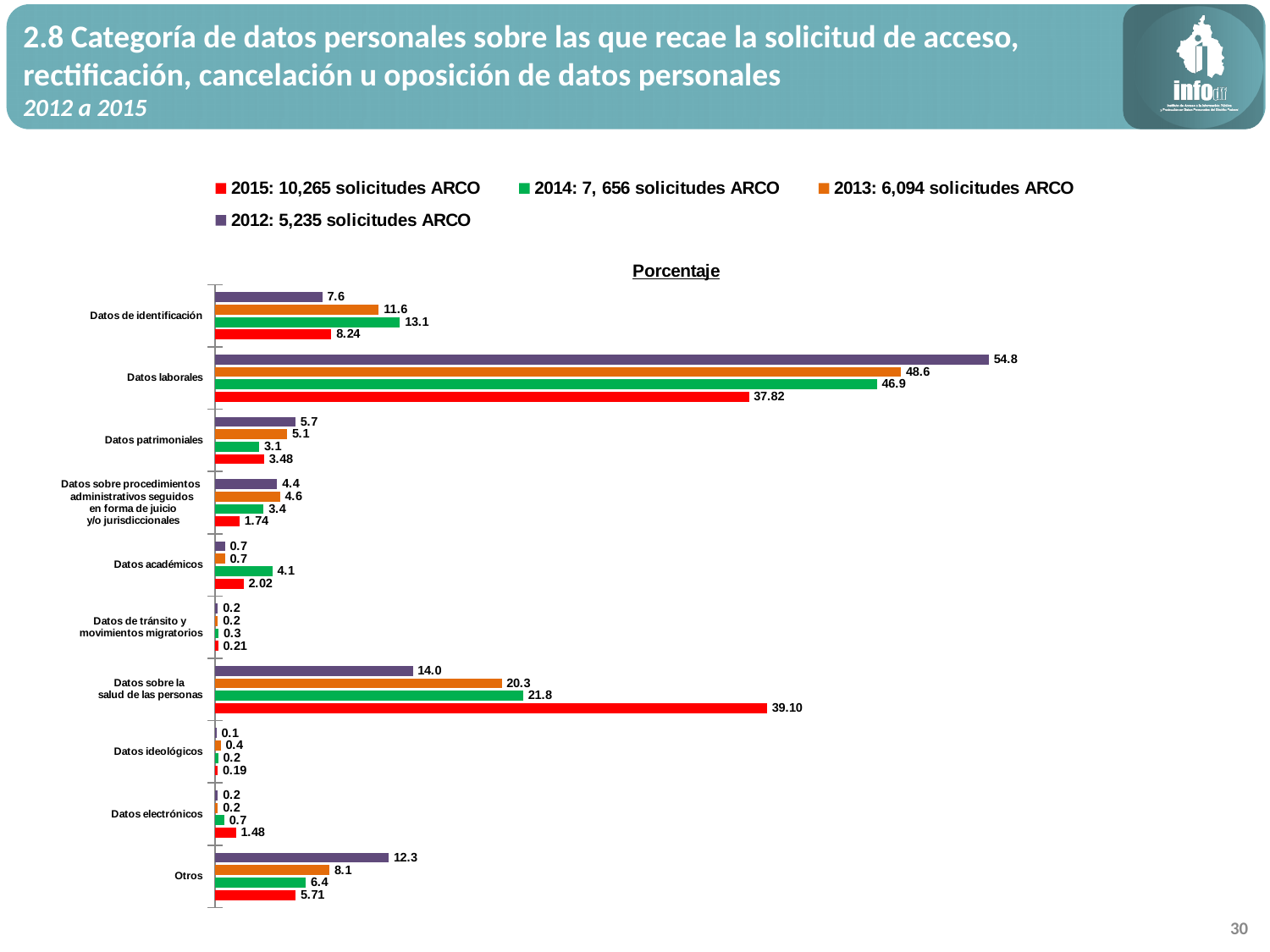
How many categories are shown on the chart? 10 What is the 2012 value for Datos sobre la salud de las personas? 14.0 What kind of chart is shown on the slide? Bar chart How many series does the legend list? 4 Which category has the lowest 2012 value? Datos ideológicos Which colour represents the 2015 series in the legend? Red What is the 2015 value for Datos laborales? 37.82 What is the 2013 value for Otros? 8.1 For Datos sobre la salud de las personas, which year has the larger value, 2015 or 2014? 2015 What is the 2014 value for Datos de identificación? 13.1 Which category has the highest 2012 value? Datos laborales What is the difference between the 2012 and 2015 values for Datos laborales? 16.98